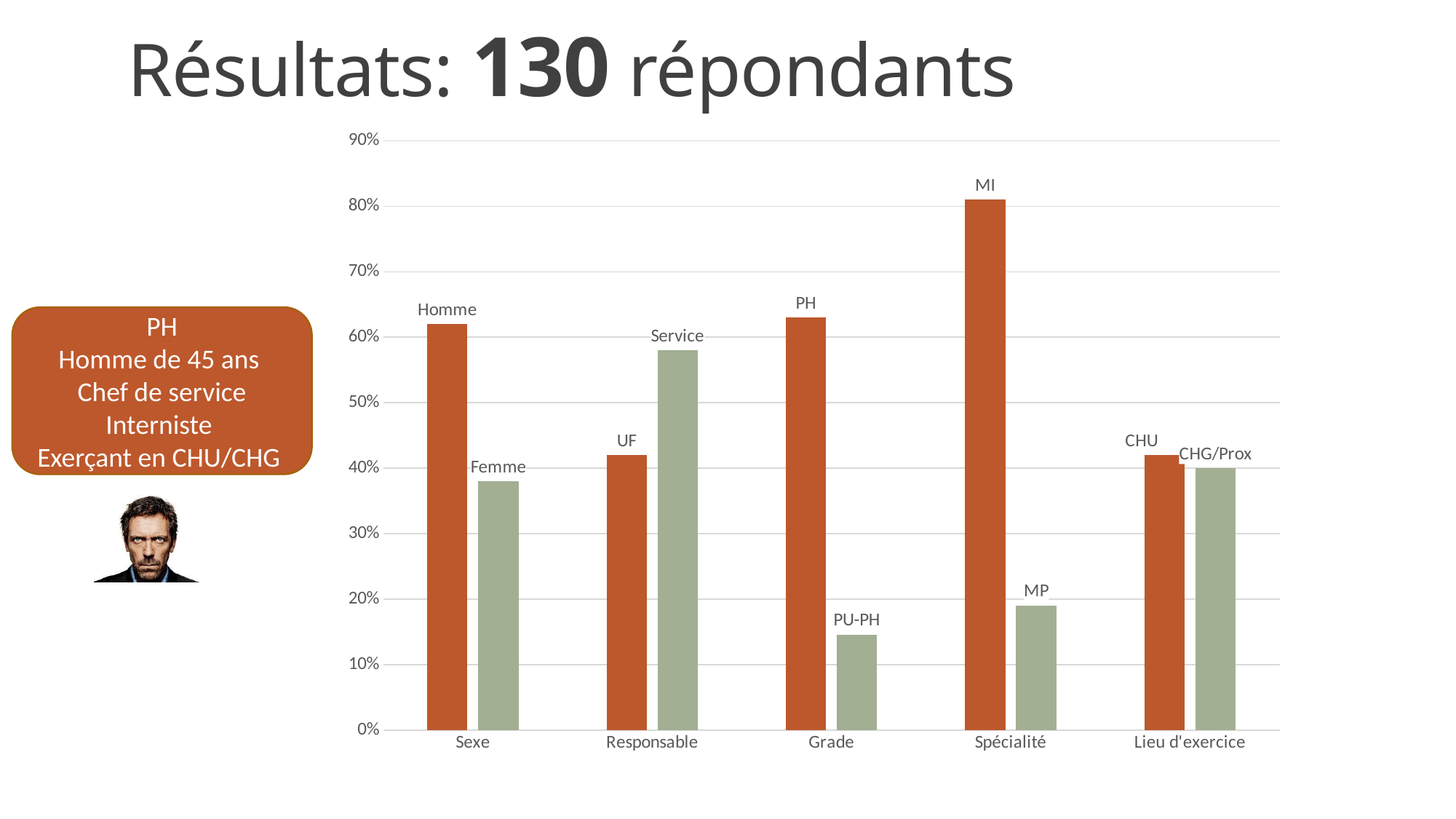
Which bar in the chart is the lowest? PU-PH Is the value for Homme greater or less than 50%? greater How many categories are shown along the x axis of the chart? 5 Which bar in the chart is the highest? MI Is the value for PU-PH greater or less than 20%? less Which is larger, the value for UF or the value for Service? Service Is the value for MP greater or less than 30%? less What kind of chart is shown on the slide? bar chart Which is larger, the value for Homme or the value for Femme? Homme What is the x-axis category label for the bars labelled PH and PU-PH? Grade